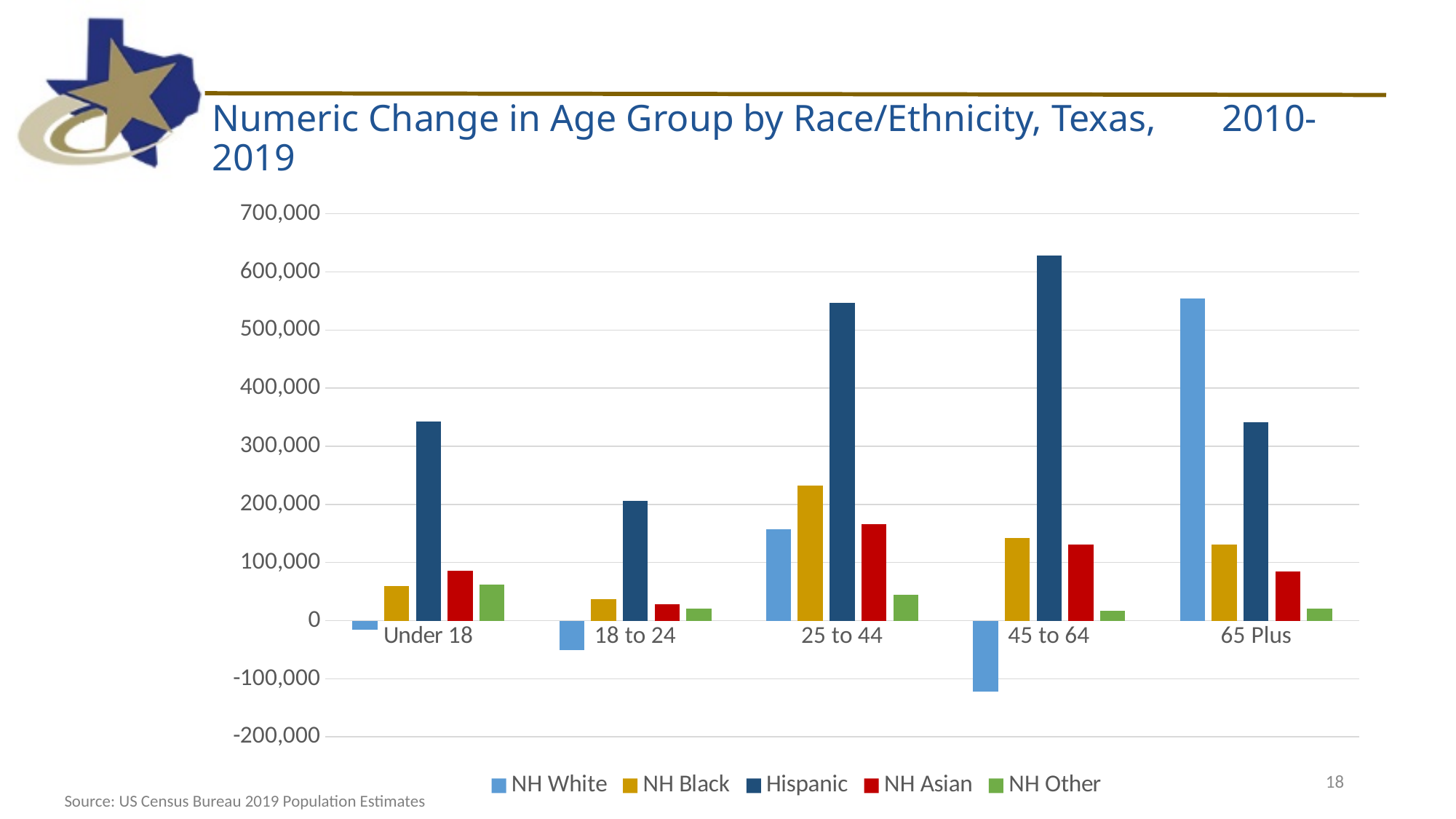
Is the NH White value for 65 Plus greater or less than 500,000? greater In which age group is the Hispanic value the highest? 45 to 64 In which age group is the Hispanic value the lowest? 18 to 24 How many series does the legend list? 5 What kind of chart is shown on the slide? Bar chart What colour represents the Hispanic series in the legend? Dark blue Is the Hispanic value for 25 to 44 greater or less than 500,000? greater How many age groups are shown on the x axis? 5 In the 25 to 44 age group, which is larger: NH Black or NH Asian? NH Black In the 65 Plus age group, which is larger: NH White or Hispanic? NH White Which series has the lowest value in the 45 to 64 age group? NH White Is the NH White value for 45 to 64 greater or less than -100,000? less